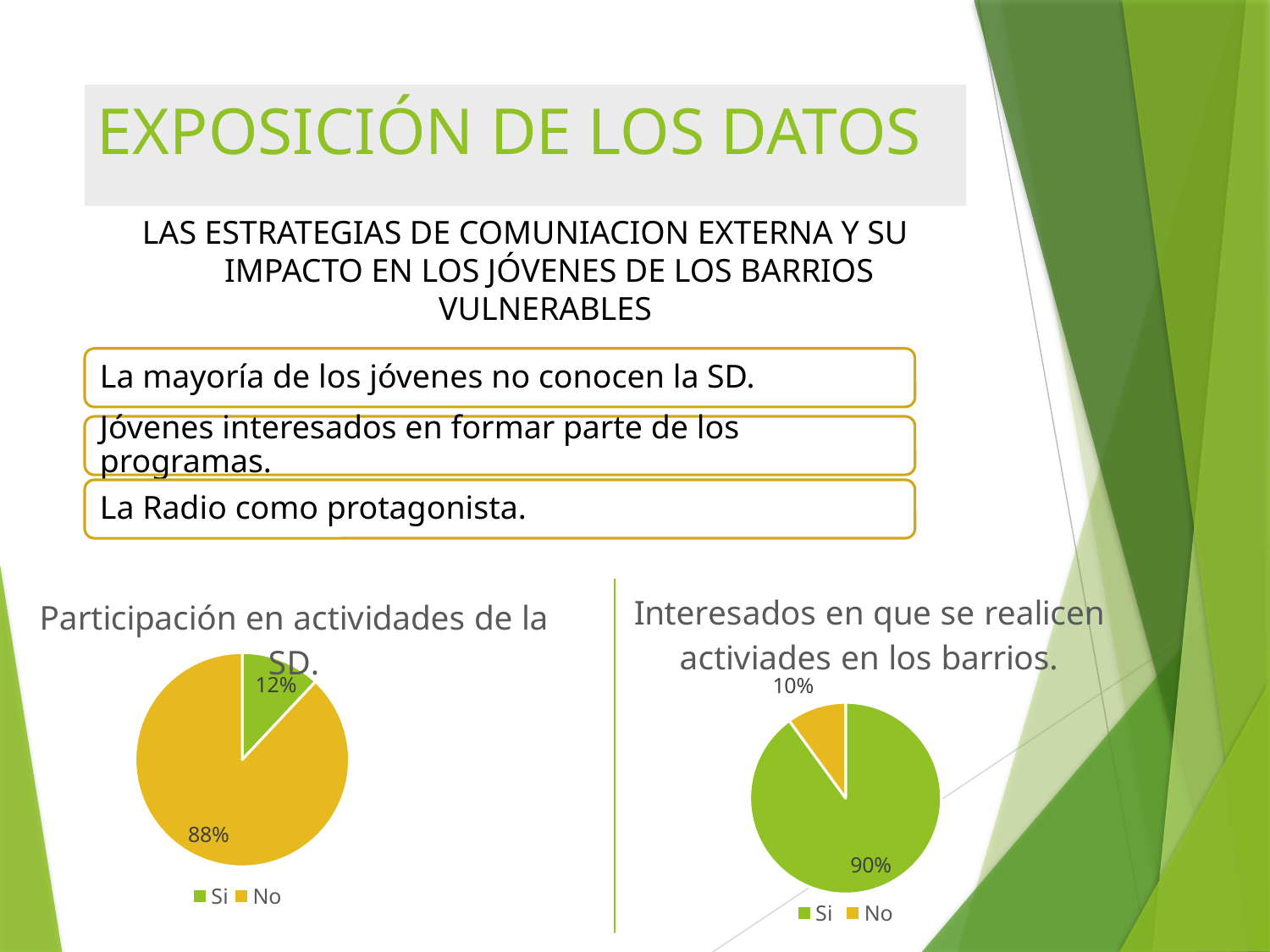
In the chart titled "Interesados en que se realicen activiades en los barrios.", what is the difference between the "Si" and "No" shares? 80% In the chart titled "Interesados en que se realicen activiades en los barrios.", what share of the pie is "Si"? 90% What type of chart is the chart on the left of the slide? Pie chart In the chart titled "Participación en actividades de la SD.", what share of the pie is "Si"? 12% In the chart titled "Participación en actividades de la SD.", which is larger, "Si" or "No"? No In the chart titled "Participación en actividades de la SD.", what colour is the "Si" slice? Green In the chart titled "Interesados en que se realicen activiades en los barrios.", what share of the pie is "No"? 10% How many series does the legend of the chart titled "Interesados en que se realicen activiades en los barrios." list? 2 In the chart titled "Interesados en que se realicen activiades en los barrios.", which category has the smallest slice? No In the chart titled "Participación en actividades de la SD.", which category has the largest slice? No In the chart titled "Participación en actividades de la SD.", what is the difference between the "No" and "Si" shares? 76%